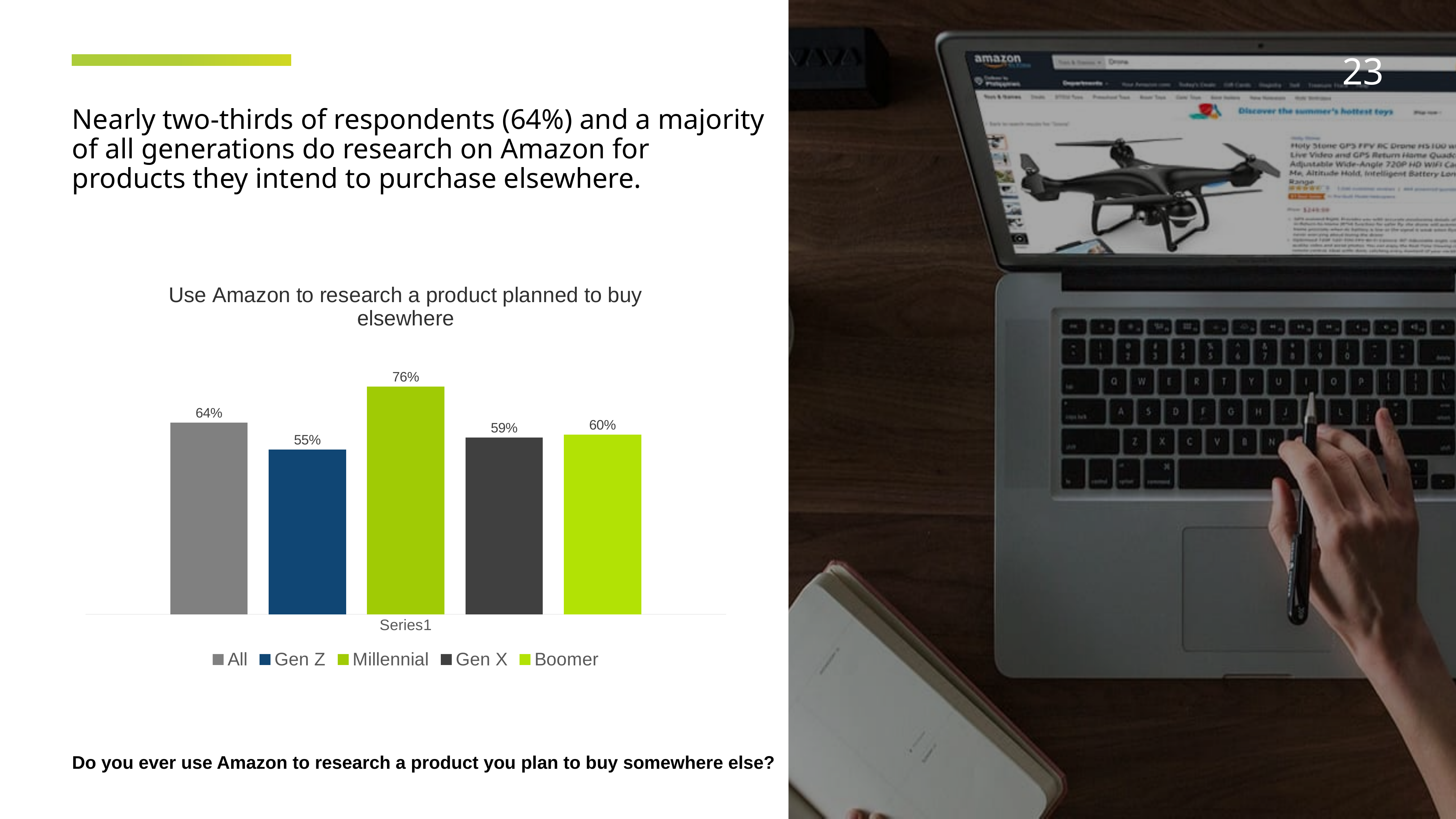
What kind of chart is shown on the slide? Bar chart Which is larger, the value for Gen X or the value for All? All What is the value for All respondents in the chart? 64% What is the title of the chart? Use Amazon to research a product planned to buy elsewhere Which group has the lowest value in the chart? Gen Z What is the difference between the Millennial value and the Gen Z value? 21% What is the value for Gen Z in the chart? 55% Which group has the highest value in the chart? Millennial What is the value for Millennial in the chart? 76% How many bars are plotted in the chart? 5 What is the difference between the Boomer value and the Gen X value? 1% What is the value for Boomer in the chart? 60%